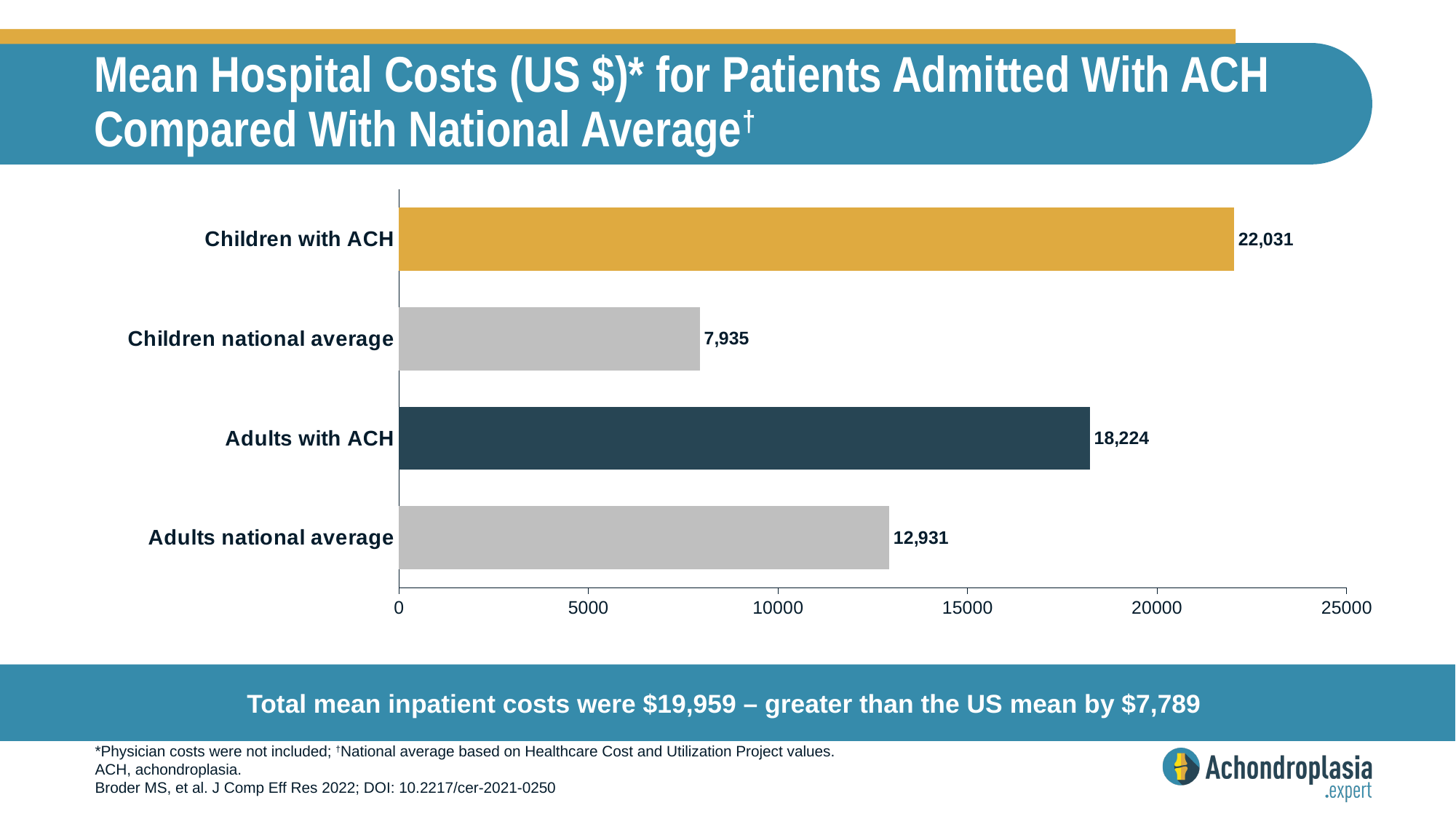
What is the mean hospital cost for Children with ACH? 22,031 What kind of chart is shown on the slide? Bar chart What is the difference between the mean hospital cost for Adults with ACH and the Adults national average? 5,293 Is the value for Adults national average greater or less than 10000? greater What is the mean hospital cost for Children national average? 7,935 What is the mean hospital cost for Adults national average? 12,931 How many categories are shown in the chart? 4 What is the maximum value shown on the x axis? 25000 What is the difference between the mean hospital cost for Children with ACH and the Children national average? 14,096 Which is larger, the mean hospital cost for Adults with ACH or for Children with ACH? Children with ACH Which category has the lowest mean hospital cost? Children national average Which category has the highest mean hospital cost? Children with ACH